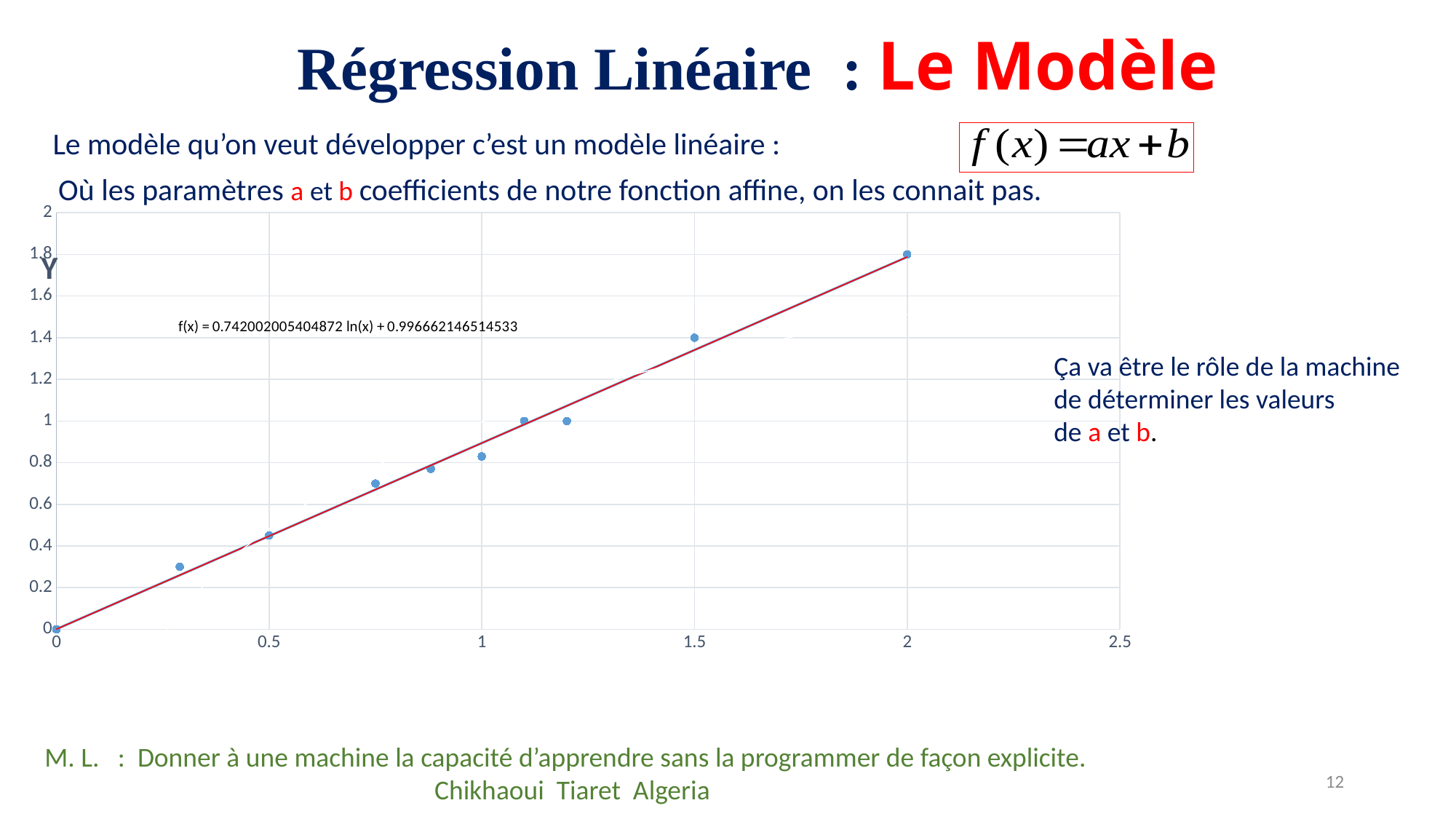
What kind of chart is shown on the slide? scatter chart Do the plotted values rise or fall as x increases? rise Which has the larger y value: the point at x = 1.5 or the point at x = 0.5? the point at x = 1.5 Is the y value of the point at x = 2 greater or less than 1.6? greater What is the maximum value shown on the x axis? 2.5 Is the y value of the point at x = 1.5 greater or less than 1.2? greater Is the y value of the point at x = 0.5 greater or less than 0.6? less What is the trendline equation printed on the chart? f(x) = 0.742002005404872 ln(x) + 0.996662146514533 Which data point has the highest y value? the point at x = 2 Which data point has the lowest y value? the point at x = 0